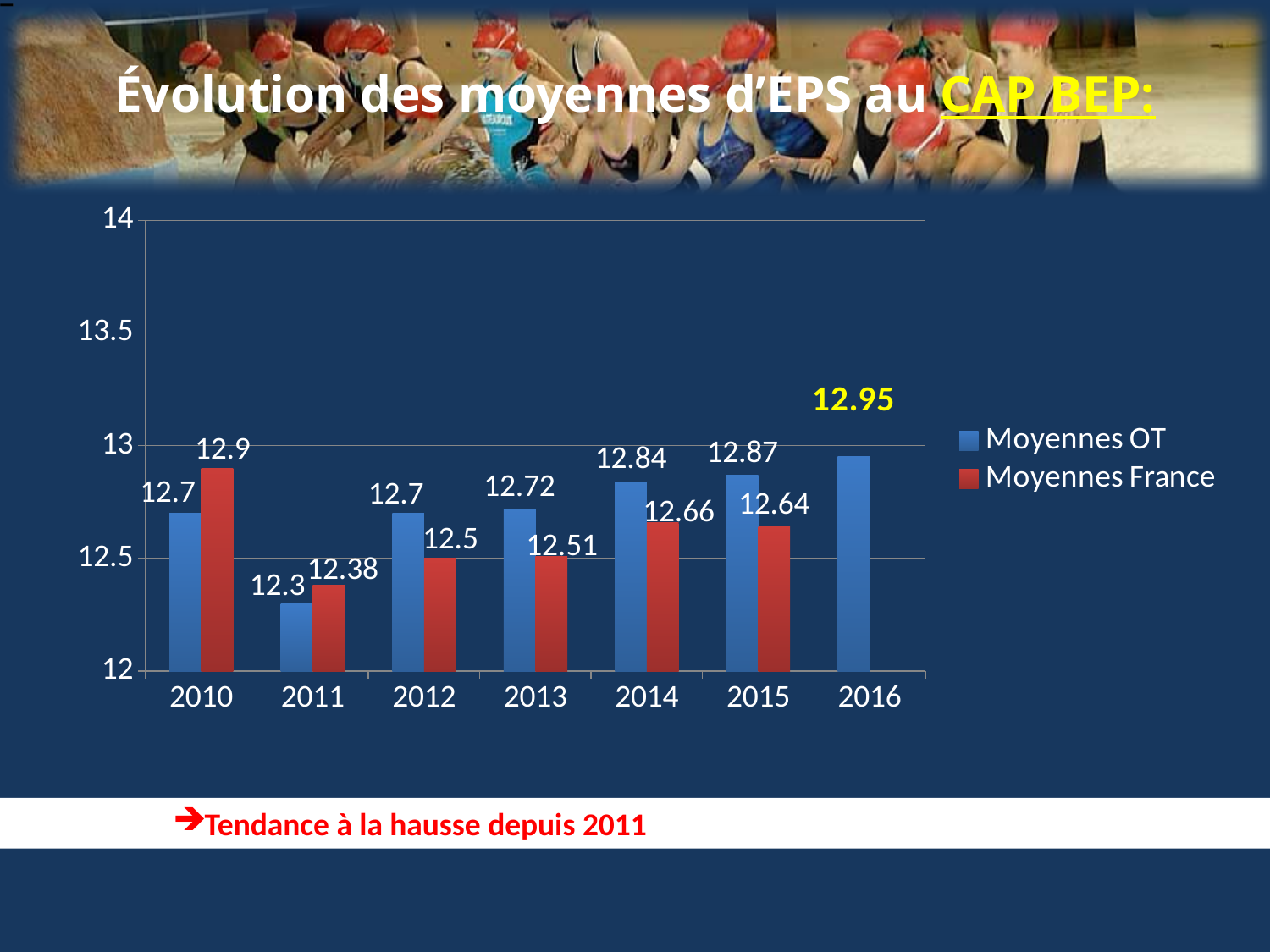
How many series does the legend list? 2 What is the value of Moyennes OT for 2016? 12.95 What is the value of Moyennes France for 2014? 12.66 Is the value of Moyennes OT for 2016 greater or less than 13? less How many years are shown on the x axis? 7 Which year has the highest value for Moyennes France? 2010 What kind of chart is shown on the slide? bar chart In 2010, which is larger: Moyennes OT or Moyennes France? Moyennes France Which year has the lowest value for Moyennes OT? 2011 What is the difference between Moyennes OT and Moyennes France in 2015? 0.23 What is the value of Moyennes OT for 2011? 12.3 What is the value of Moyennes France for 2010? 12.9